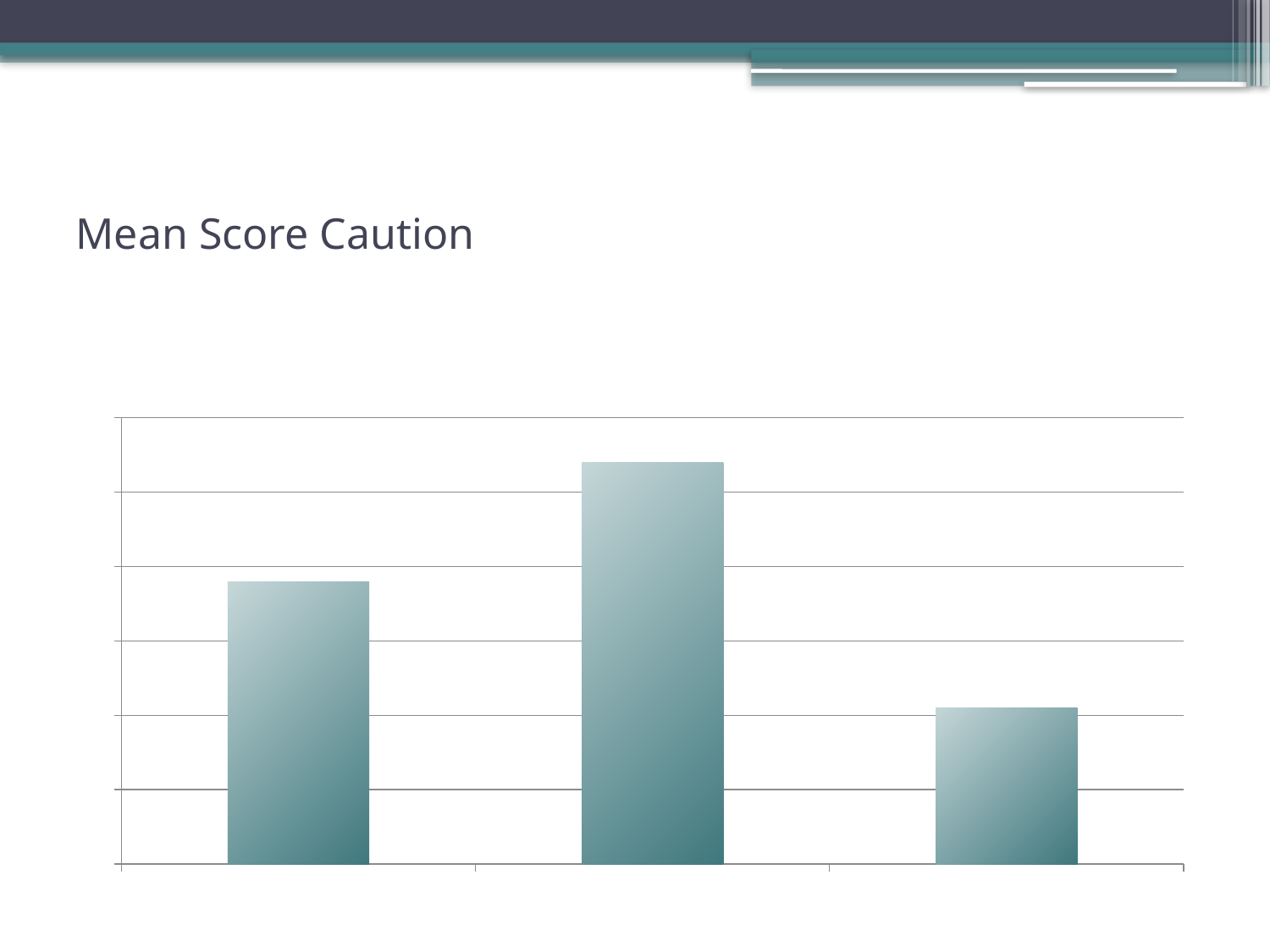
What kind of chart is shown on the slide? bar chart Which bar is the shortest: the left, middle, or right bar? right Is the middle bar or the left bar taller? middle What is the title text shown on the slide above the chart? Mean Score Caution Which bar is the tallest: the left, middle, or right bar? middle Is the left bar or the right bar taller? left Does the chart display a legend? No How many bars does the chart show? 3